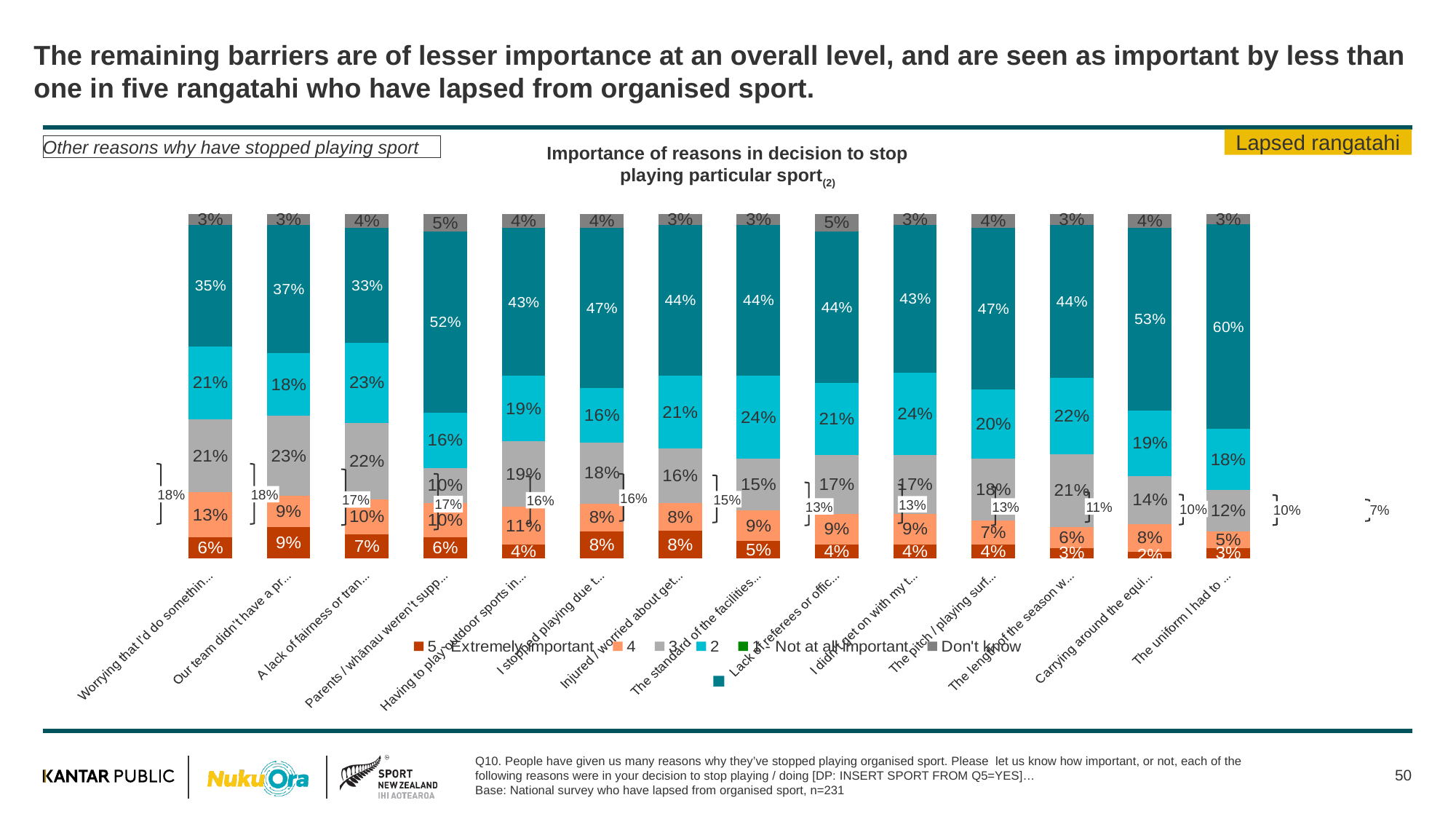
Which reason has the highest '1 - Not at all important' share? The uniform I had to ... How many reasons (categories) are plotted in the chart? 14 What is the 'Don't know' percentage for 'Parents / whānau weren't supp...'? 5% Which has a larger '3' share: 'Our team didn't have a pr...' or 'Worrying that I'd do somethin...'? Our team didn't have a pr... Which reason has the lowest '5 - Extremely important' share? Carrying around the equi... What percentage rated 'Our team didn't have a pr...' as '5 - Extremely important'? 9% What is the title of the chart? Importance of reasons in decision to stop playing particular sport What percentage rated 'The uniform I had to ...' as '1 - Not at all important'? 60% What is the difference between the '1 - Not at all important' share for 'The uniform I had to ...' and for 'Worrying that I'd do somethin...'? 25 percentage points What percentage rated 'The standard of the facilities...' as '2'? 24% What percentage rated 'Worrying that I'd do somethin...' as '4'? 13% What kind of chart is shown on the slide? Stacked bar chart